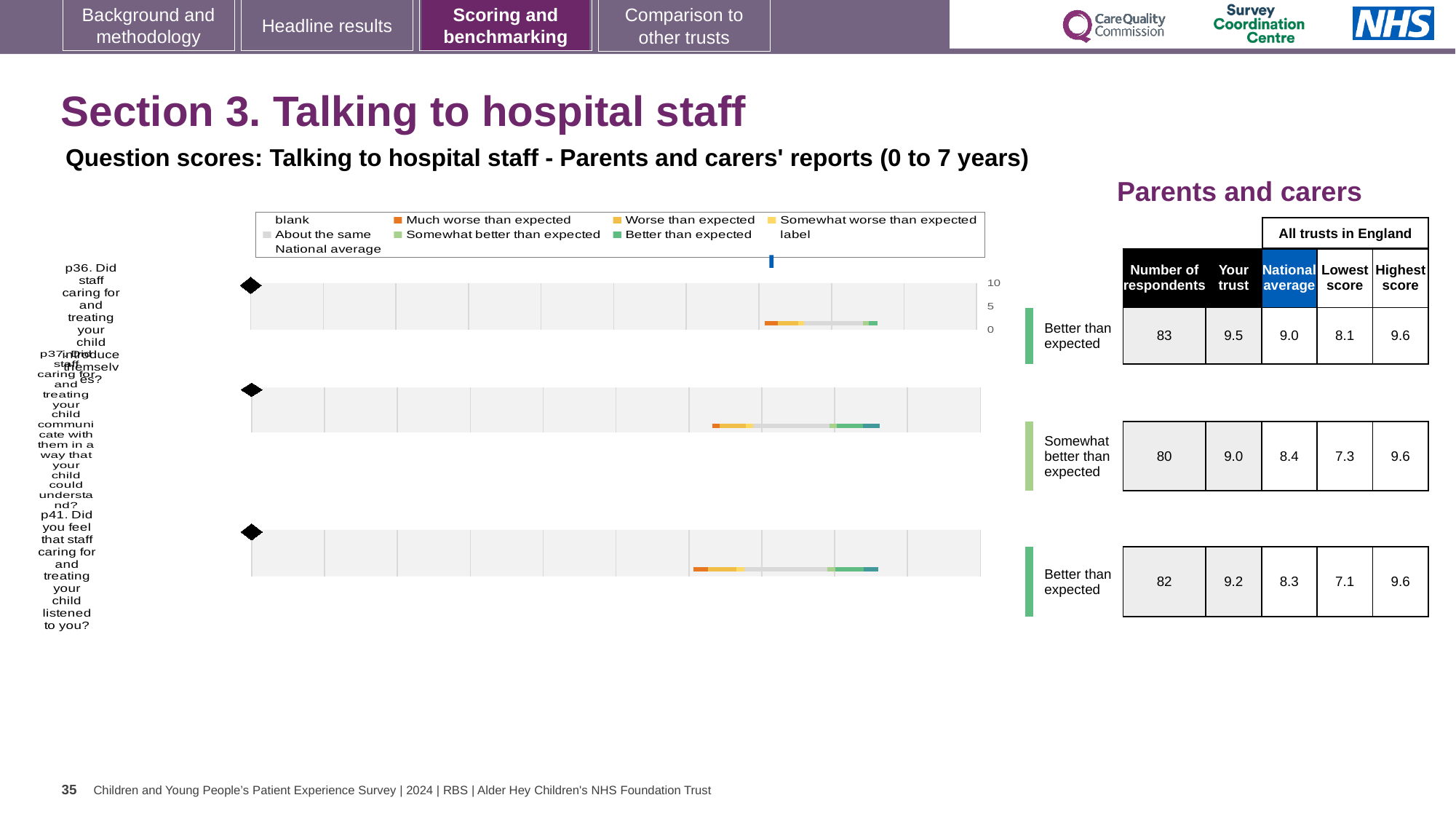
In the table next to the chart, what is the 'Your trust' score for the bottom question (p41)? 9.2 In the table next to the chart, which question has the highest 'Your trust' score? p36 In the table next to the chart, what is the national average for the middle question (p37)? 8.4 What kind of chart is shown on the slide? bar chart In the table next to the chart, how many respondents are listed for the top question (p36)? 83 In the table next to the chart, is the 'Your trust' score for the middle question (p37) larger or smaller than that for the bottom question (p41)? smaller Which colour does the legend use for 'Much worse than expected'? orange How many questions (categories) are plotted in the chart? 3 What is the highest tick value shown on the chart's axis? 10 In the table next to the chart, what is the lowest score across all trusts in England for the middle question (p37)? 7.3 In the table next to the chart, what is the difference between the 'Your trust' score and the national average for the top question (p36)? 0.5 How many entries does the chart legend list? 9